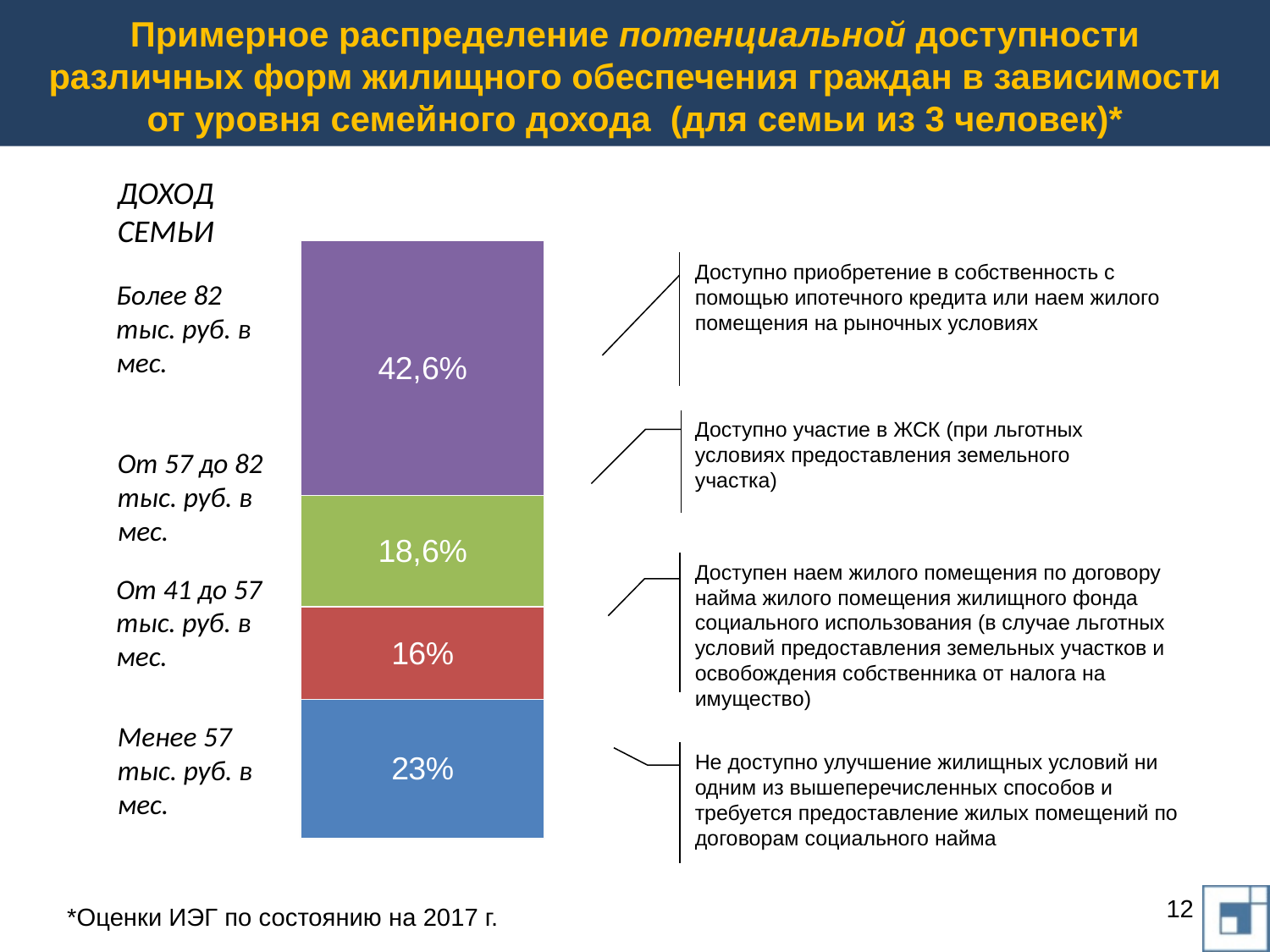
What is the value of the bottom (blue) segment of the stacked bar? 23% What kind of chart is shown on the slide? stacked bar chart Which segment of the stacked bar has the largest value? the top (purple) segment, 42,6% How many segments does the stacked bar contain? 4 What is the difference between the purple segment (42,6%) and the green segment (18,6%)? 24% Which is larger: the blue segment or the red segment? the blue segment (23%) What colour is the segment labelled 23%? blue What is the value of the top (purple) segment of the stacked bar? 42,6% What is the value of the red segment of the stacked bar? 16% Which segment of the stacked bar has the smallest value? the red segment, 16% What is the value of the green segment of the stacked bar? 18,6% What is the total of all four segments of the stacked bar? 100,2%